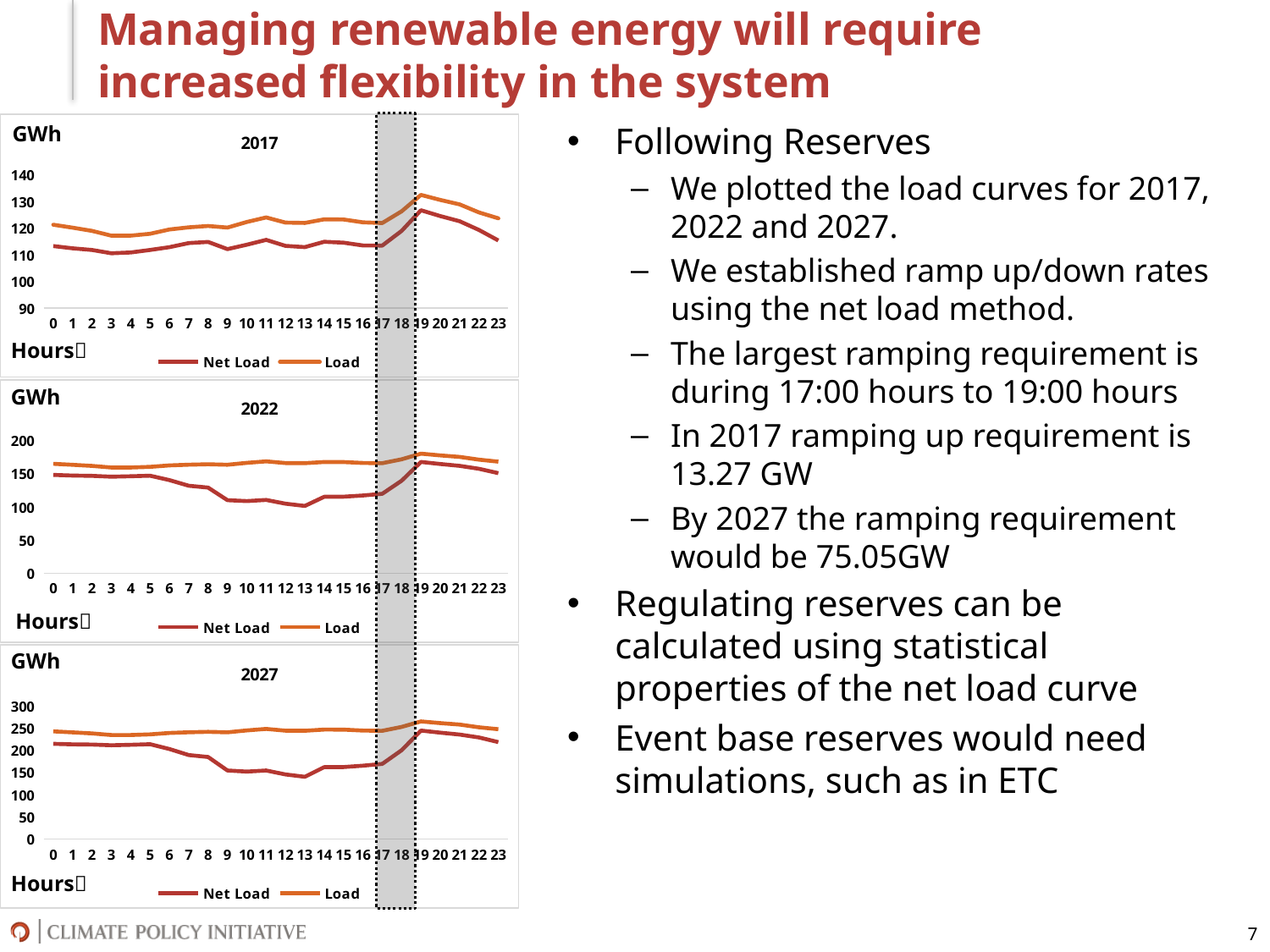
In the 2027 chart, at which hour does the Net Load series reach its highest value? 19 In the 2022 chart, is the Load value at hour 19 greater or less than 150? greater How many series does the legend of the 2022 chart list? 2 In the 2022 chart, which series has the larger value at hour 13, Load or Net Load? Load In the 2027 chart, is the Load value at hour 0 greater or less than 200? greater In the 2017 chart, is the Net Load value at hour 3 greater or less than 120? less How many hour points are plotted along the x axis of the 2027 chart? 24 What kind of chart is the 2017 chart? line chart What unit is shown on the y axis of the 2022 chart? GWh